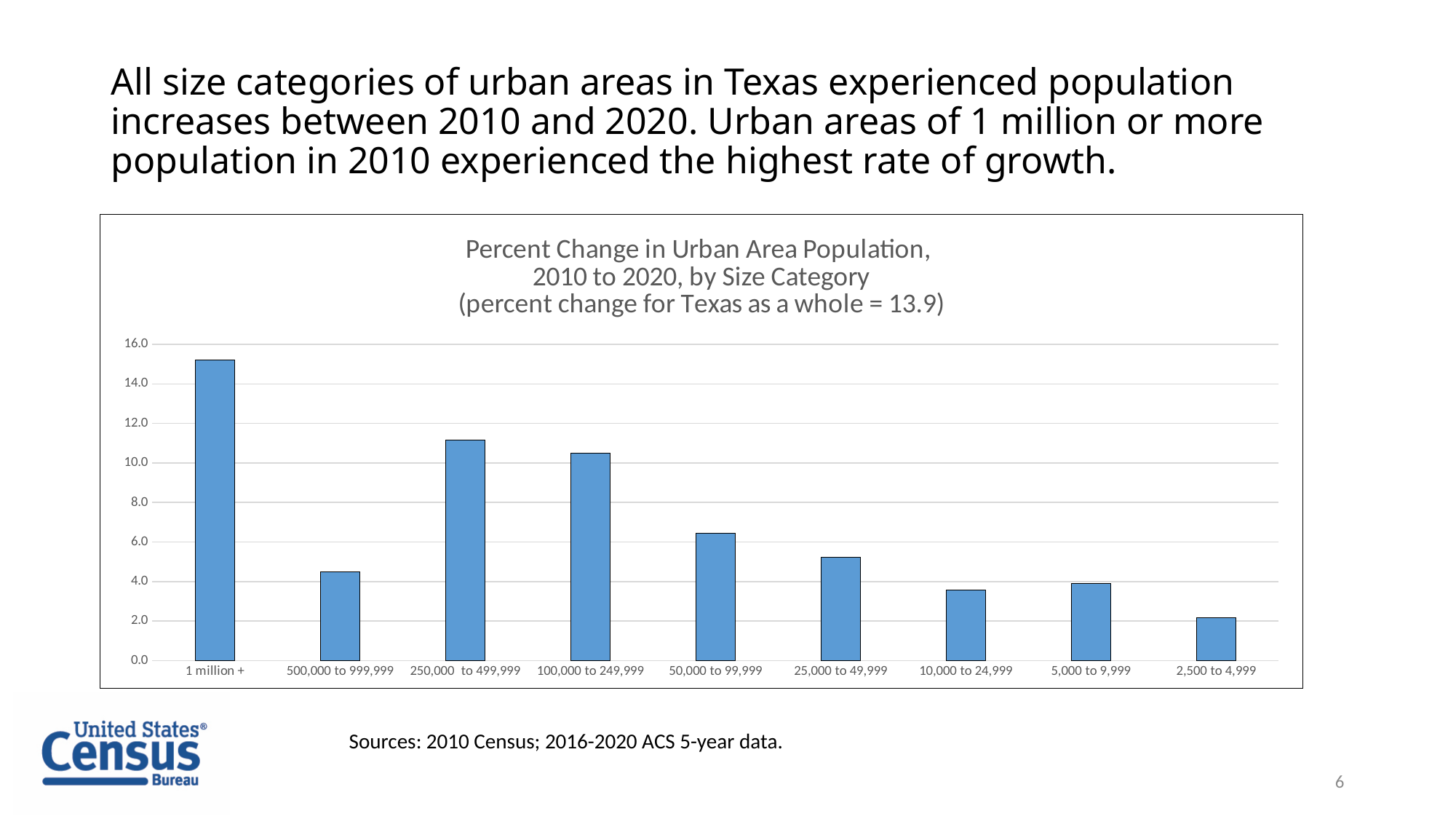
How many size categories are shown on the x axis of the chart? 9 What kind of chart is shown on the slide? bar chart According to the chart title, what is the percent change for Texas as a whole? 13.9 Which size category has the highest percent change in urban area population? 1 million + Is the value for 500,000 to 999,999 greater or less than 6.0? less Is the value for 1 million + greater or less than 14.0? greater Which has the larger percent change: 100,000 to 249,999 or 25,000 to 49,999? 100,000 to 249,999 Is the value for 250,000 to 499,999 greater or less than 10.0? greater Which has the larger percent change: 250,000 to 499,999 or 500,000 to 999,999? 250,000 to 499,999 Which size category has the lowest percent change in urban area population? 2,500 to 4,999